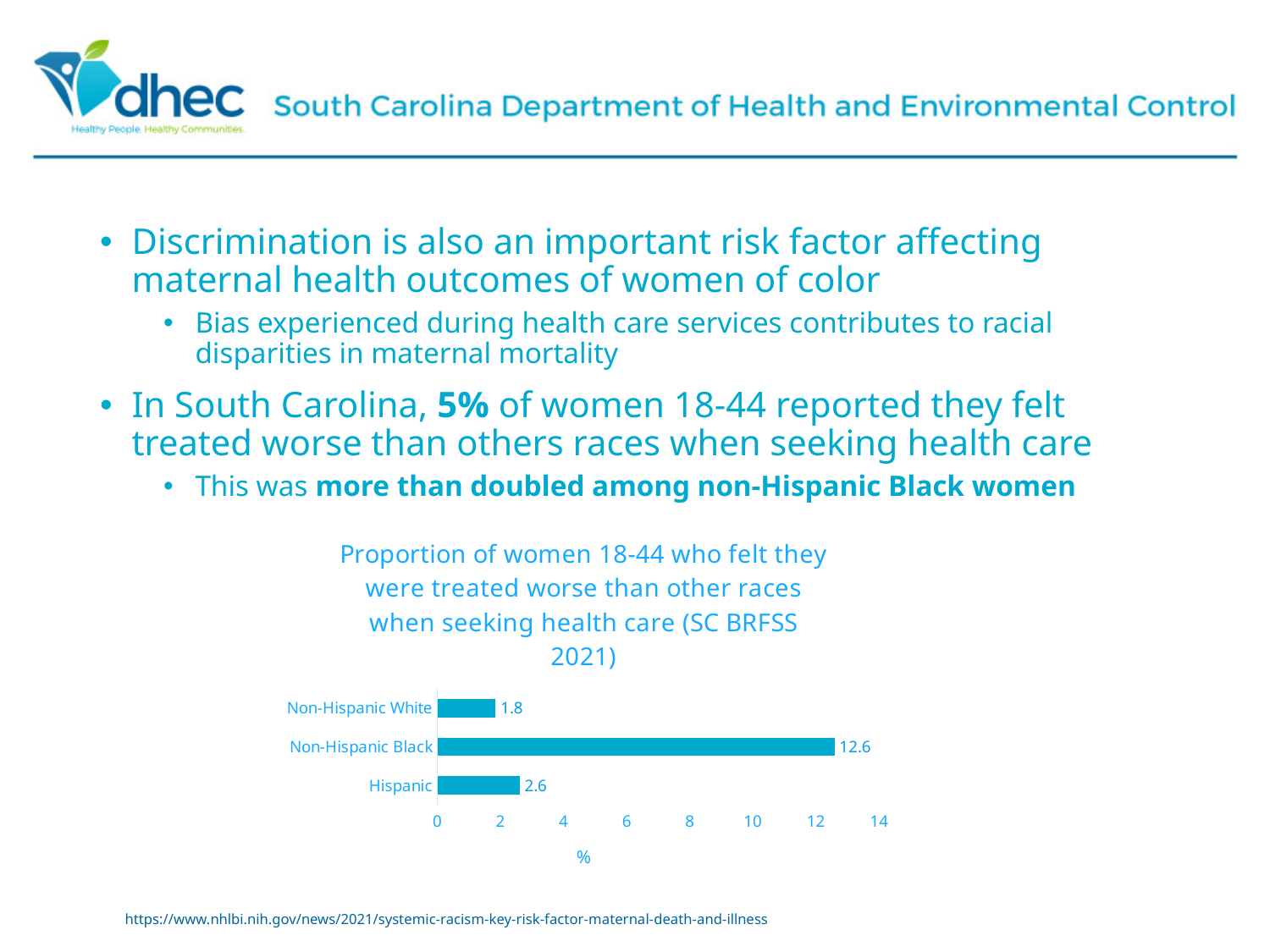
What is the value for Non-Hispanic Black women in the chart? 12.6 Which category has the lowest value in the chart? Non-Hispanic White What is the value for Non-Hispanic White women in the chart? 1.8 What unit is shown on the x axis of the chart? % What kind of chart is shown on the slide? Bar chart Is the value for Non-Hispanic Black women greater or less than 10? greater What is the difference between the values for Non-Hispanic Black and Non-Hispanic White women? 10.8 What is the value for Hispanic women in the chart? 2.6 Which category has the highest value in the chart? Non-Hispanic Black What is the difference between the values for Hispanic and Non-Hispanic White women? 0.8 Which is larger, the value for Hispanic women or for Non-Hispanic White women? Hispanic How many categories are shown in the chart? 3